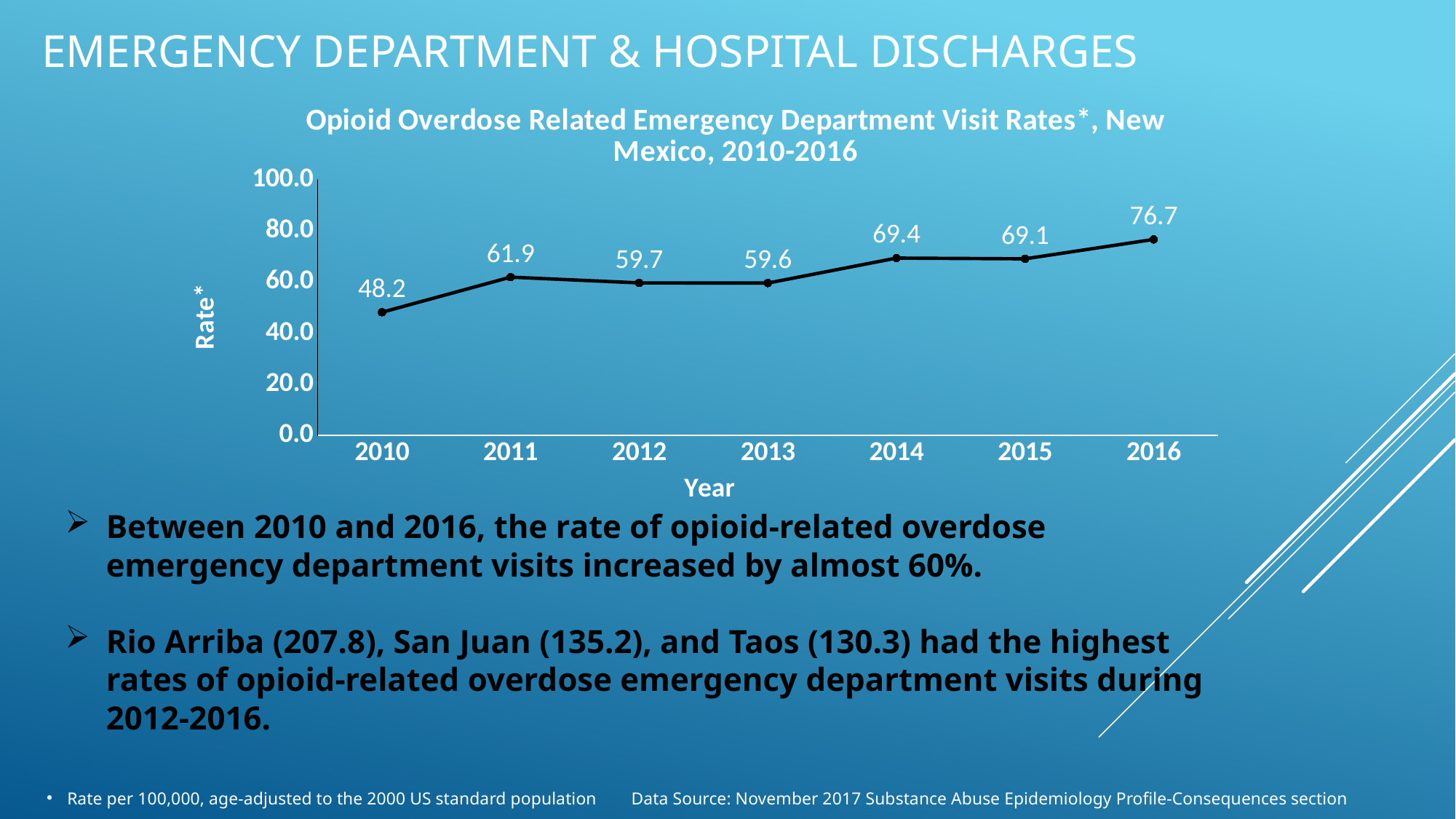
What is the difference between the rates in 2011 and 2012? 2.2 What was the opioid overdose related emergency department visit rate in 2014? 69.4 What was the opioid overdose related emergency department visit rate in New Mexico in 2010? 48.2 Which year had the lowest opioid overdose related emergency department visit rate? 2010 What type of chart is shown on the slide? Line chart What was the rate in 2016? 76.7 What is the label on the vertical axis of the chart? Rate* Which year had a higher rate, 2011 or 2014? 2014 Which year had the highest opioid overdose related emergency department visit rate? 2016 How many years are plotted on the chart? 7 By how much did the rate increase from 2010 to 2016? 28.5 Overall, does the rate rise or fall from 2010 to 2016? Rise